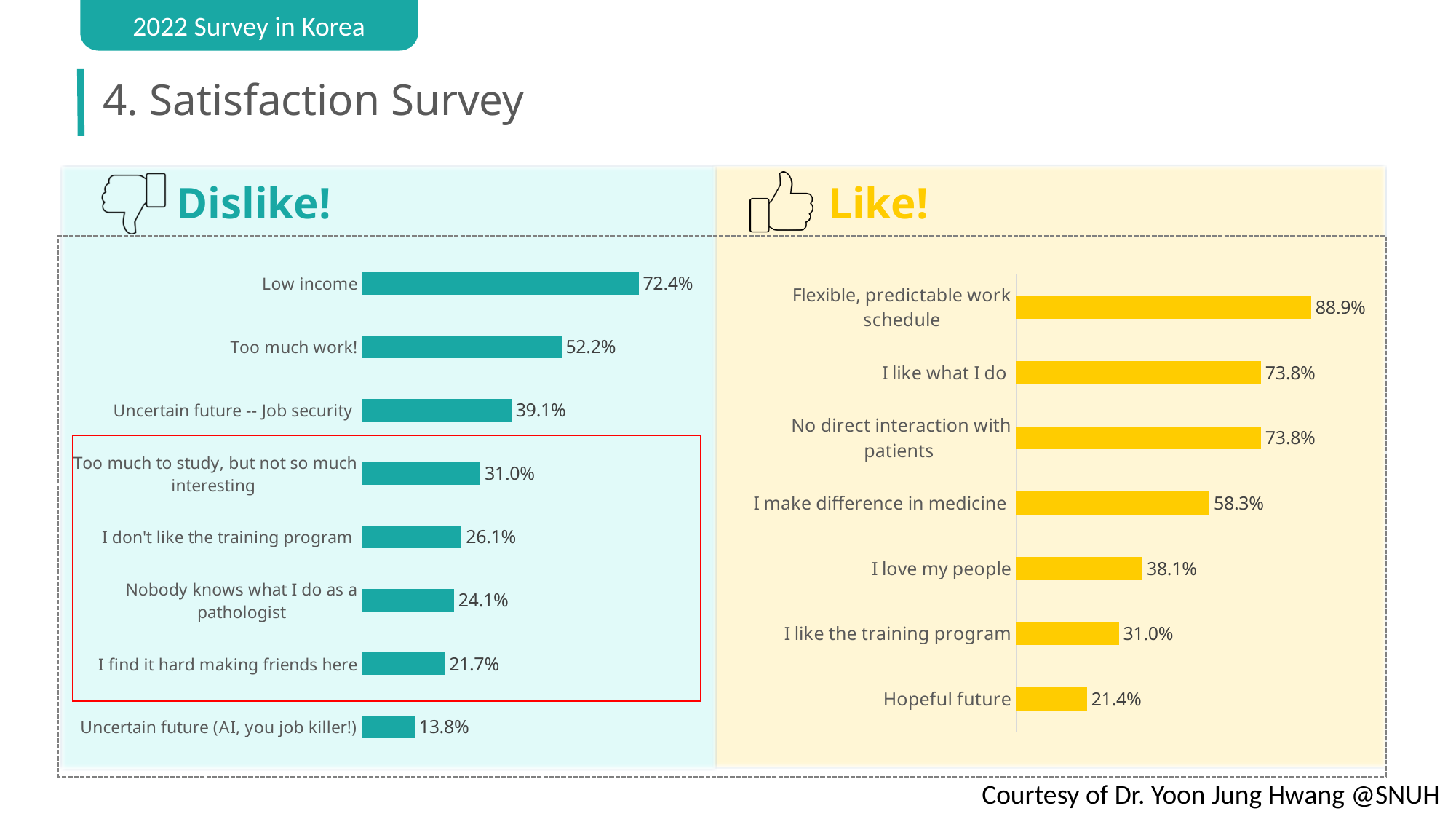
In the Dislike! chart, which is larger: Uncertain future -- Job security or I don't like the training program? Uncertain future -- Job security In the Dislike! chart, what is the value for Low income? 72.4% In the Like! chart, what is the value for I like the training program? 31.0% In the Like! chart, what is the difference between I love my people and Hopeful future? 16.7% How many categories are shown in the Dislike! chart? 8 In the Dislike! chart, what is the difference between Low income and Too much work!? 20.2% In the Dislike! chart, which category has the lowest value? Uncertain future (AI, you job killer!) What colour are the bars in the Dislike! chart? Teal What kind of chart is the Like! chart? Bar chart In the Like! chart, what is the value for I make difference in medicine? 58.3% How many categories are shown in the Like! chart? 7 In the Like! chart, which category has the highest value? Flexible, predictable work schedule